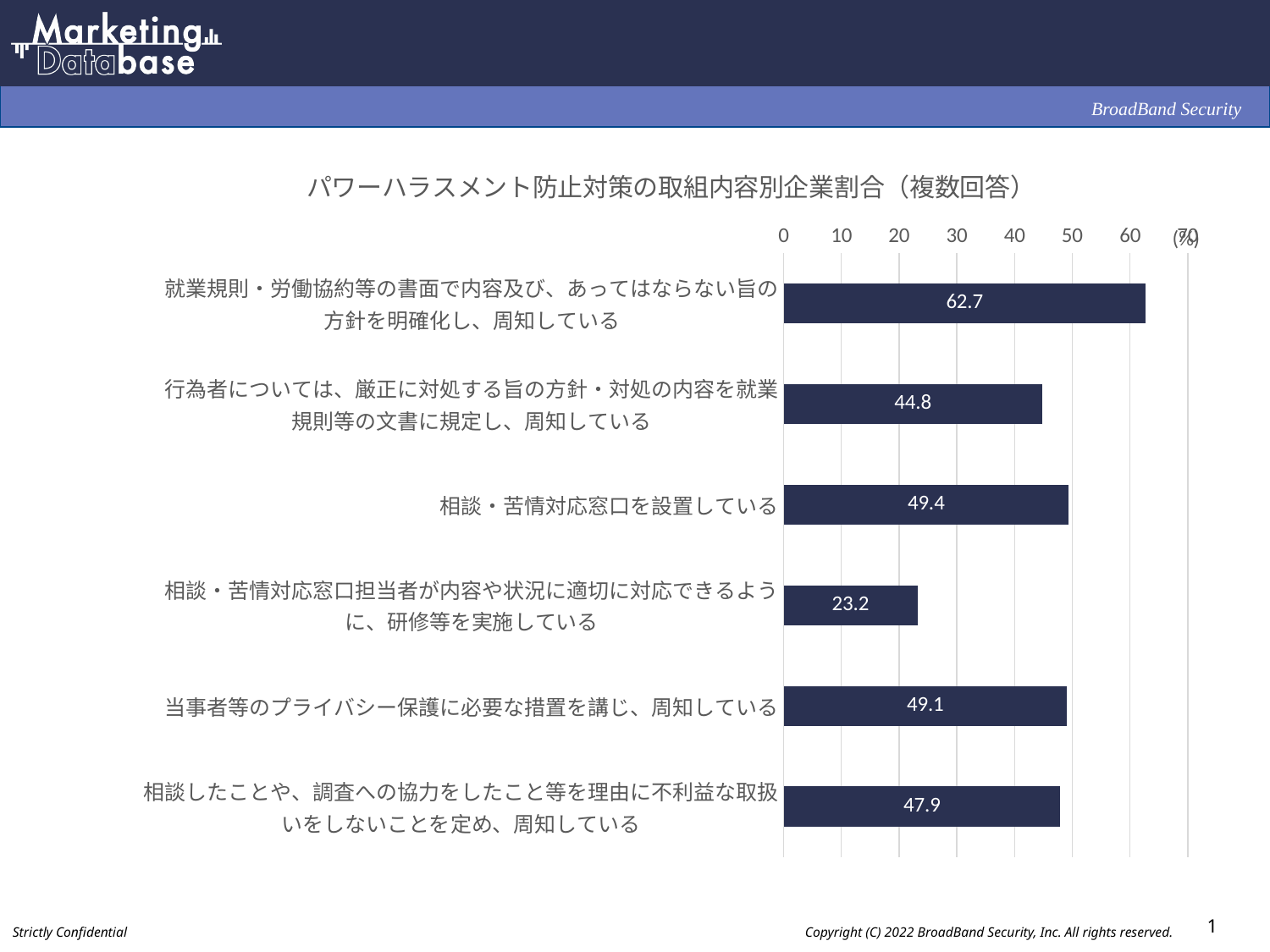
Is the value for 「就業規則・労働協約等の書面で内容及び、あってはならない旨の方針を明確化し、周知している」 greater or less than 60? greater What kind of chart is shown on the slide? bar chart What is the title of the chart? パワーハラスメント防止対策の取組内容別企業割合（複数回答） What is the value for 「当事者等のプライバシー保護に必要な措置を講じ、周知している」? 49.1 Which category has the lowest value? 相談・苦情対応窓口担当者が内容や状況に適切に対応できるように、研修等を実施している What is the difference between the value for 「就業規則・労働協約等の書面で内容及び、あってはならない旨の方針を明確化し、周知している」 and the value for 「行為者については、厳正に対処する旨の方針・対処の内容を就業規則等の文書に規定し、周知している」? 17.9 What is the value for 「相談・苦情対応窓口を設置している」? 49.4 Which category has the highest value? 就業規則・労働協約等の書面で内容及び、あってはならない旨の方針を明確化し、周知している What is the value for 「相談・苦情対応窓口担当者が内容や状況に適切に対応できるように、研修等を実施している」? 23.2 What is the difference between the value for 「相談・苦情対応窓口を設置している」 and the value for 「相談・苦情対応窓口担当者が内容や状況に適切に対応できるように、研修等を実施している」? 26.2 Which is larger: the value for 「行為者については、厳正に対処する旨の方針・対処の内容を就業規則等の文書に規定し、周知している」 or the value for 「相談したことや、調査への協力をしたこと等を理由に不利益な取扱いをしないことを定め、周知している」? 相談したことや、調査への協力をしたこと等を理由に不利益な取扱いをしないことを定め、周知している How many categories are shown in the chart? 6